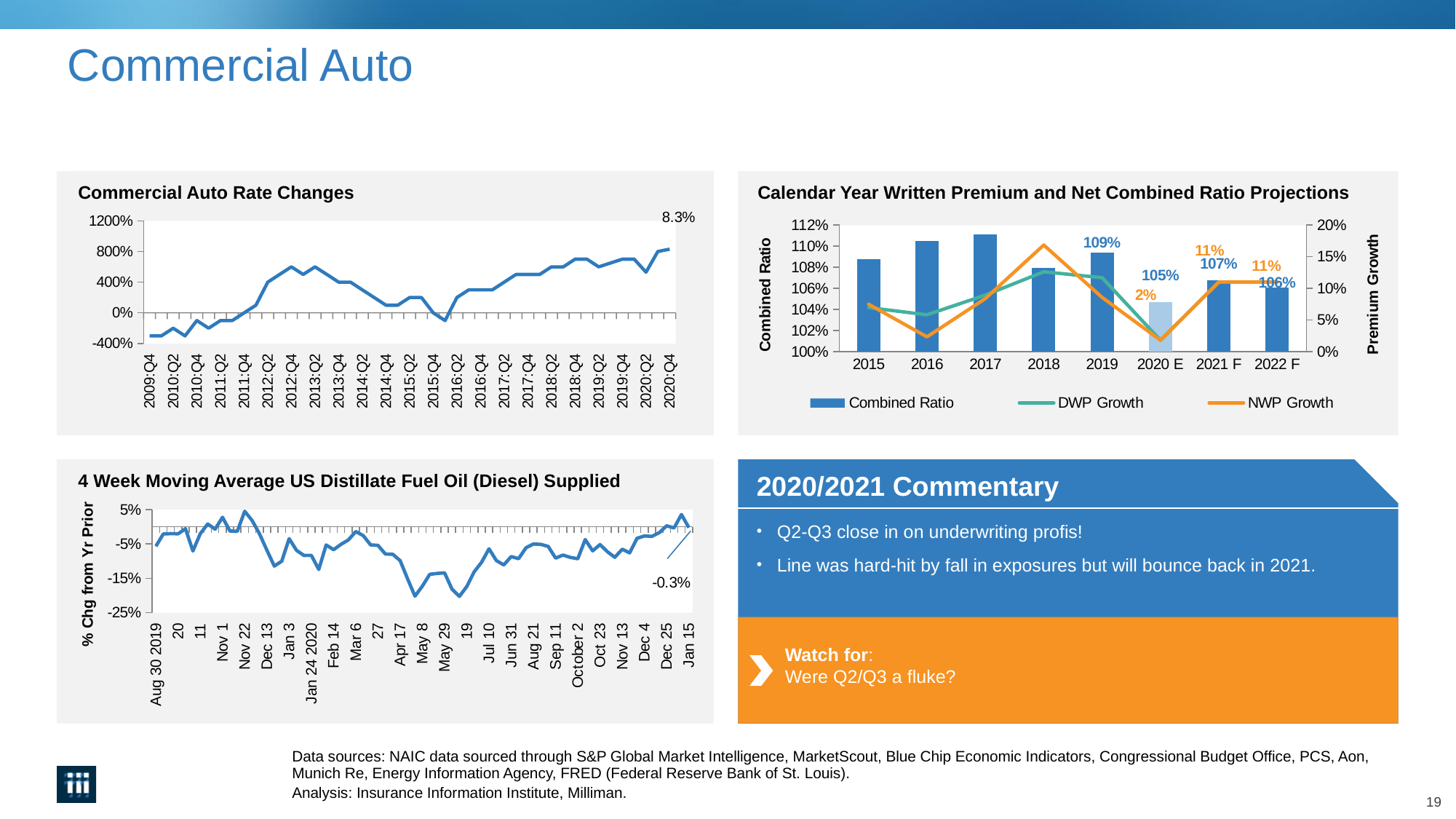
In the 'Commercial Auto Rate Changes' chart, what value is labeled at the end of the line for 2020:Q4? 8.3% In the 'Calendar Year Written Premium and Net Combined Ratio Projections' chart, how many years are shown on the x axis? 8 In the 'Calendar Year Written Premium and Net Combined Ratio Projections' chart, how many series does the legend list? 3 In the 'Calendar Year Written Premium and Net Combined Ratio Projections' chart, which year has the lowest labeled combined ratio? 2020 E What kind of chart is the 'Commercial Auto Rate Changes' chart? Line chart In the 'Calendar Year Written Premium and Net Combined Ratio Projections' chart, what is the combined ratio for 2019? 109% In the 'Calendar Year Written Premium and Net Combined Ratio Projections' chart, what premium growth is labeled for 2020 E? 2% In the 'Calendar Year Written Premium and Net Combined Ratio Projections' chart, what is the combined ratio for 2021 F? 107% In the 'Calendar Year Written Premium and Net Combined Ratio Projections' chart, is the combined ratio for 2017 greater or less than 110%? greater In the 'Calendar Year Written Premium and Net Combined Ratio Projections' chart, which is larger, the combined ratio for 2021 F or for 2022 F? 2021 F In the '4 Week Moving Average US Distillate Fuel Oil (Diesel) Supplied' chart, what value is labeled at the end of the line? -0.3% In the 'Calendar Year Written Premium and Net Combined Ratio Projections' chart, what is the difference between the combined ratio for 2019 and for 2021 F? 2 percentage points